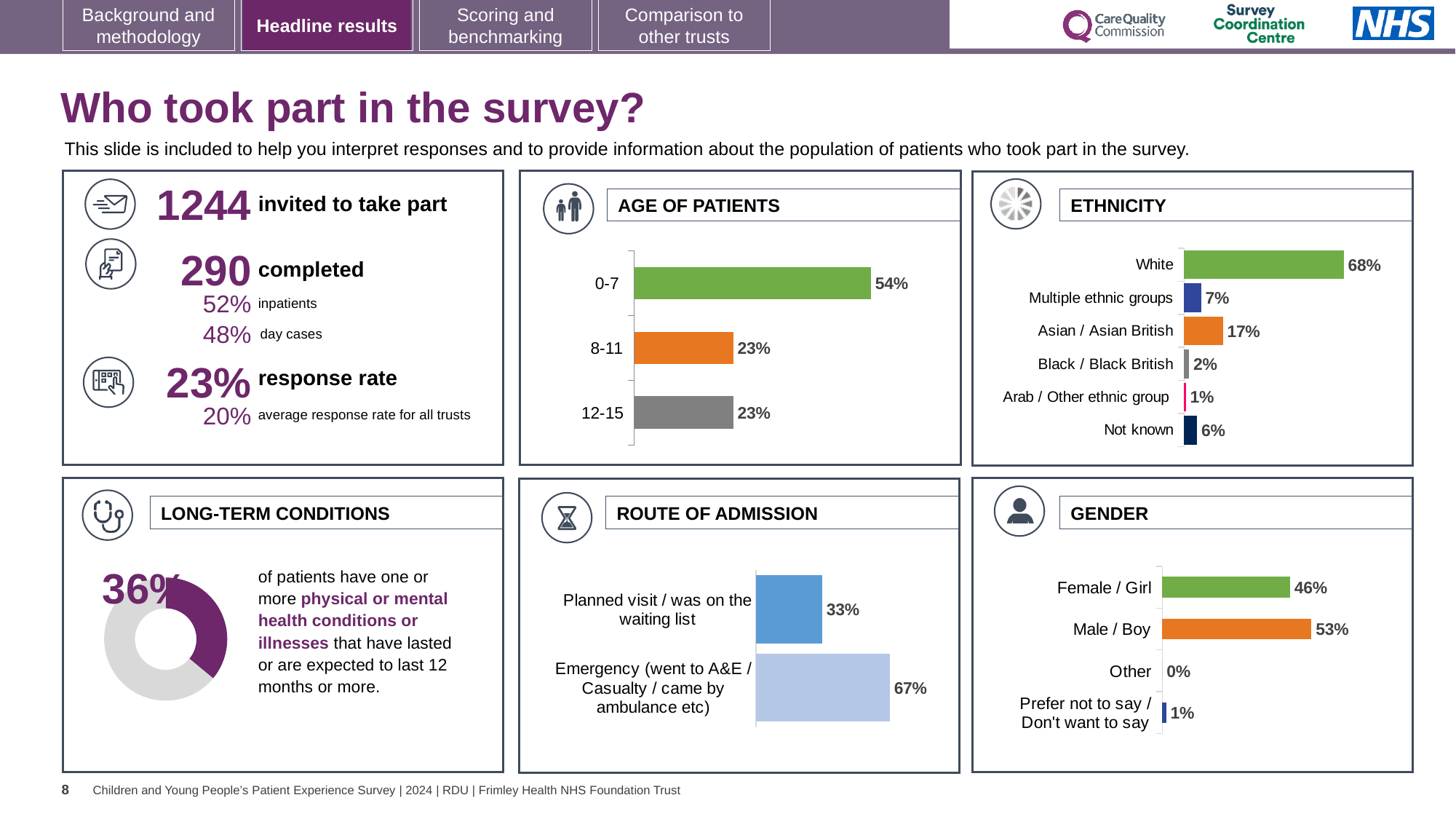
In the AGE OF PATIENTS chart, how many age groups are shown? 3 In the ETHNICITY chart, which category has the lowest value? Arab / Other ethnic group In the AGE OF PATIENTS chart, which age group has the highest value? 0-7 In the GENDER chart, what is the difference between the Male / Boy and Female / Girl values? 7% In the ROUTE OF ADMISSION chart, which route has the larger value: Planned visit / was on the waiting list or Emergency? Emergency (went to A&E / Casualty / came by ambulance etc) What kind of chart is used in the LONG-TERM CONDITIONS panel? Donut chart In the ETHNICITY chart, how many categories are shown? 6 In the ETHNICITY chart, what is the value for Asian / Asian British? 17% In the GENDER chart, what is the value for Male / Boy? 53% In the ETHNICITY chart, what is the difference between the White and Not known values? 62% In the AGE OF PATIENTS chart, what percentage of patients are aged 0-7? 54% In the ROUTE OF ADMISSION chart, what percentage of patients came via Emergency (went to A&E / Casualty / came by ambulance etc)? 67%